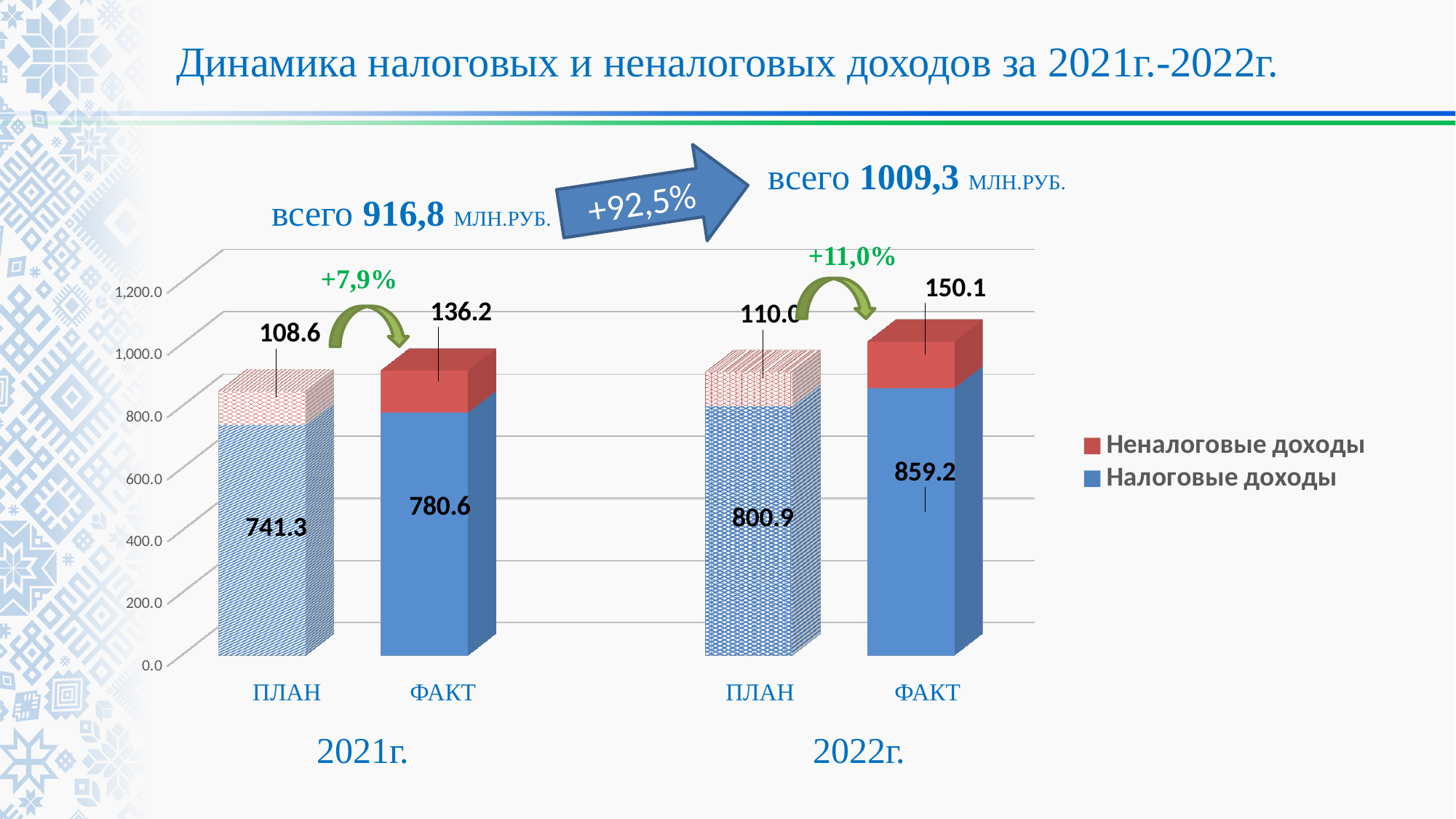
What is the value of Налоговые доходы for ПЛАН 2021г.? 741.3 What is the total of the stacked bar for ФАКТ 2021г.? 916.8 Which bar has the lowest value of Неналоговые доходы? ПЛАН 2021г. What type of chart is shown on the slide? Stacked bar chart How many bars are plotted in the chart? 4 Which is larger: Неналоговые доходы for ФАКТ 2021г. or for ФАКТ 2022г.? ФАКТ 2022г. What is the value of Неналоговые доходы for ФАКТ 2021г.? 136.2 What is the value of Неналоговые доходы for ПЛАН 2022г.? 110.0 Which bar has the highest value of Налоговые доходы? ФАКТ 2022г. What is the value of Налоговые доходы for ФАКТ 2022г.? 859.2 How many series does the legend list? 2 What is the difference between Налоговые доходы for ФАКТ 2022г. and ПЛАН 2022г.? 58.3